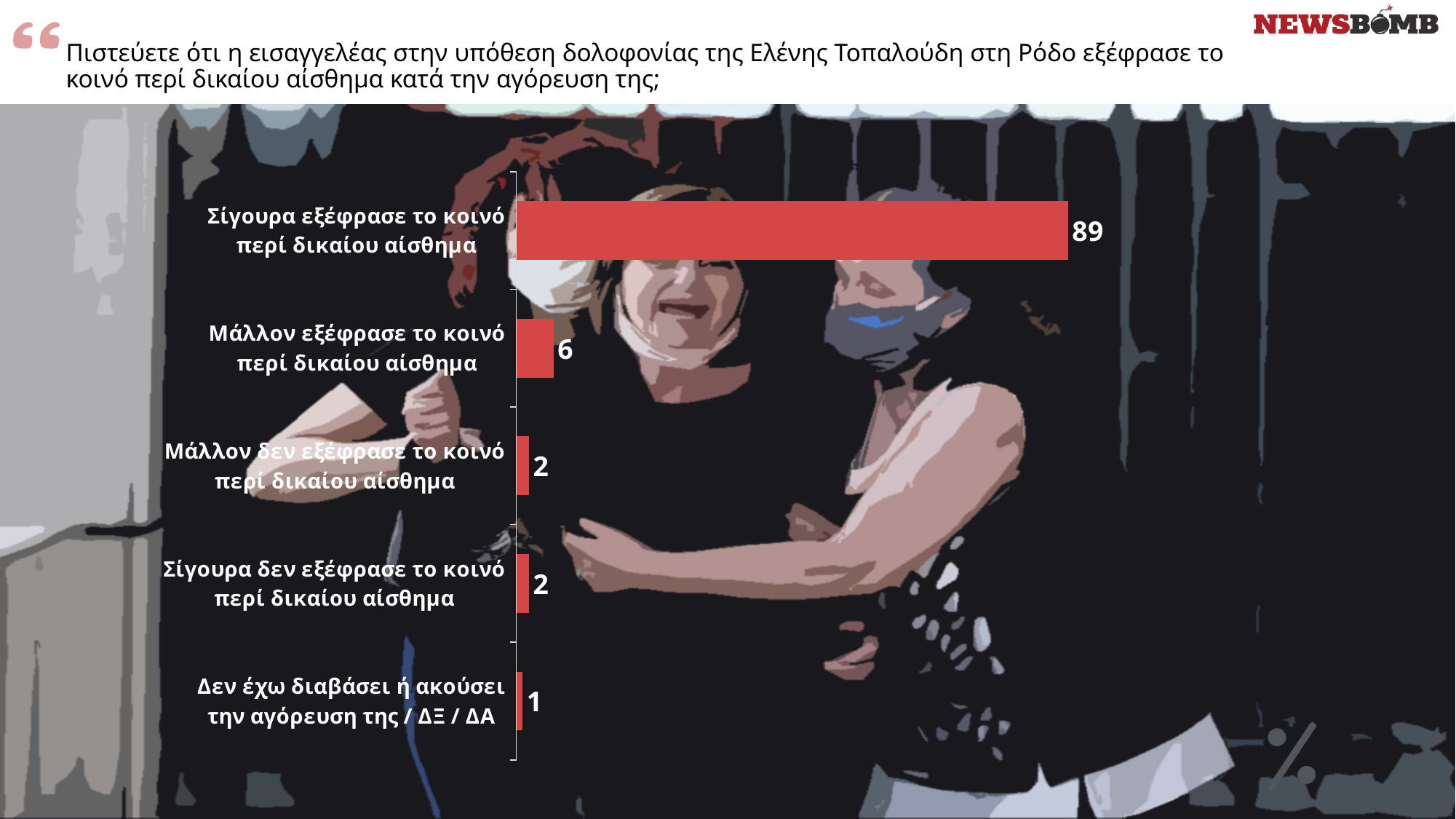
Which category has the lowest value? Δεν έχω διαβάσει ή ακούσει την αγόρευση της / ΔΞ / ΔΑ What colour are the bars in the chart? Red What is the value for "Δεν έχω διαβάσει ή ακούσει την αγόρευση της / ΔΞ / ΔΑ"? 1 What is the value for "Σίγουρα εξέφρασε το κοινό περί δικαίου αίσθημα"? 89 Which is larger: the value for "Μάλλον εξέφρασε το κοινό περί δικαίου αίσθημα" or for "Σίγουρα δεν εξέφρασε το κοινό περί δικαίου αίσθημα"? Μάλλον εξέφρασε το κοινό περί δικαίου αίσθημα What is the combined value of "Μάλλον δεν εξέφρασε το κοινό περί δικαίου αίσθημα" and "Σίγουρα δεν εξέφρασε το κοινό περί δικαίου αίσθημα"? 4 What is the difference between the values for "Σίγουρα εξέφρασε το κοινό περί δικαίου αίσθημα" and "Μάλλον εξέφρασε το κοινό περί δικαίου αίσθημα"? 83 What kind of chart is shown on the slide? Bar chart How many categories does the chart show? 5 What is the value for "Μάλλον εξέφρασε το κοινό περί δικαίου αίσθημα"? 6 What is the value for "Μάλλον δεν εξέφρασε το κοινό περί δικαίου αίσθημα"? 2 Which category has the highest value? Σίγουρα εξέφρασε το κοινό περί δικαίου αίσθημα